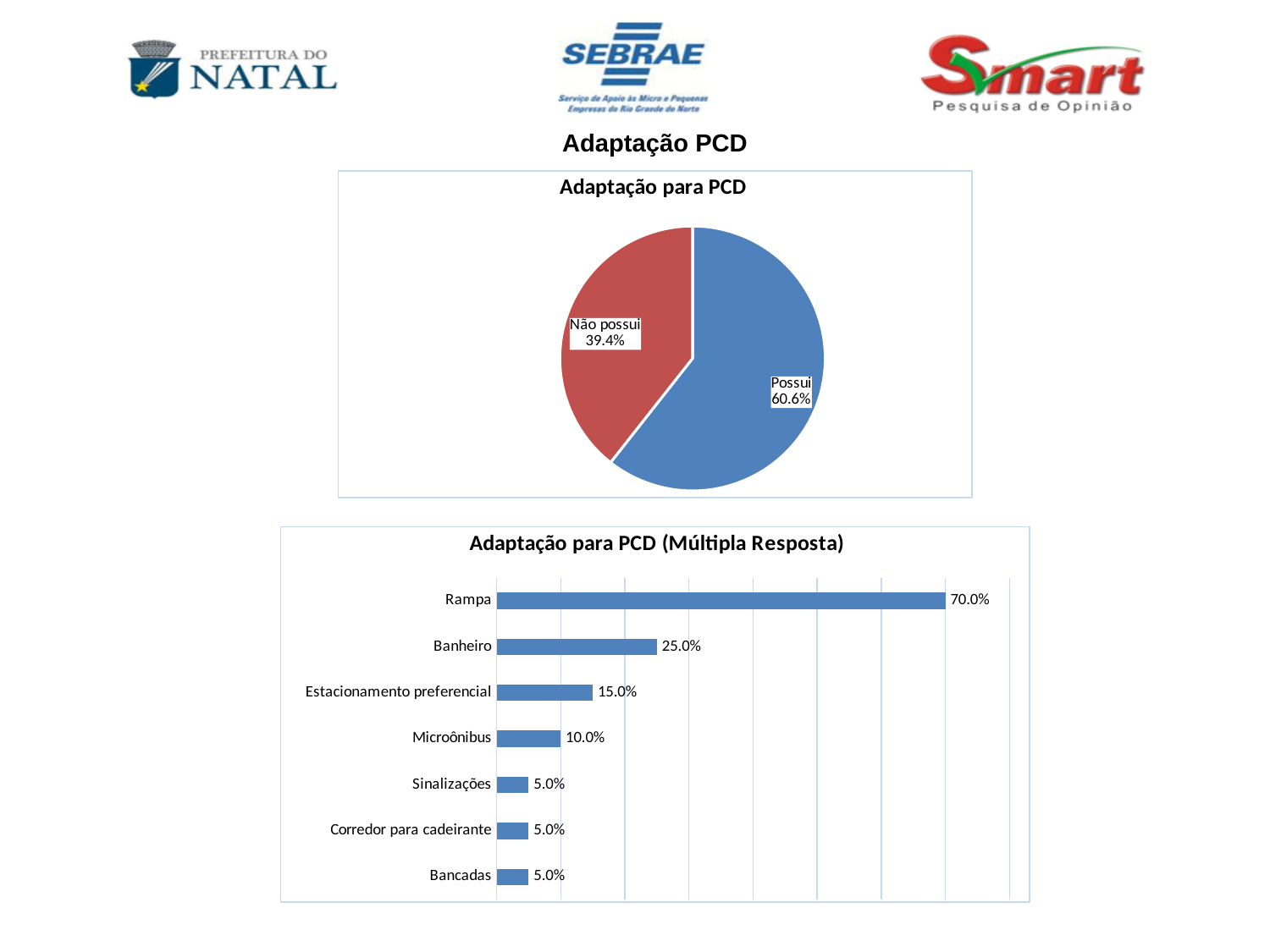
What kind of chart is the 'Adaptação para PCD' chart at the top of the slide? Pie chart In the 'Adaptação para PCD (Múltipla Resposta)' chart, what is the value for 'Banheiro'? 25.0% In the 'Adaptação para PCD' pie chart, what is the difference between the 'Possui' and 'Não possui' shares? 21.2% In the 'Adaptação para PCD (Múltipla Resposta)' chart, what is the value for 'Rampa'? 70.0% In the 'Adaptação para PCD (Múltipla Resposta)' chart, which category has the highest value? Rampa In the 'Adaptação para PCD' pie chart, what share is labelled 'Possui'? 60.6% What kind of chart is 'Adaptação para PCD (Múltipla Resposta)'? Bar chart In the 'Adaptação para PCD' pie chart, which slice is larger, 'Possui' or 'Não possui'? Possui In the 'Adaptação para PCD (Múltipla Resposta)' chart, what is the value for 'Estacionamento preferencial'? 15.0% In the 'Adaptação para PCD' pie chart, what share is labelled 'Não possui'? 39.4% In the 'Adaptação para PCD (Múltipla Resposta)' chart, what is the difference between 'Rampa' and 'Banheiro'? 45.0% In the 'Adaptação para PCD (Múltipla Resposta)' chart, how many categories are shown? 7